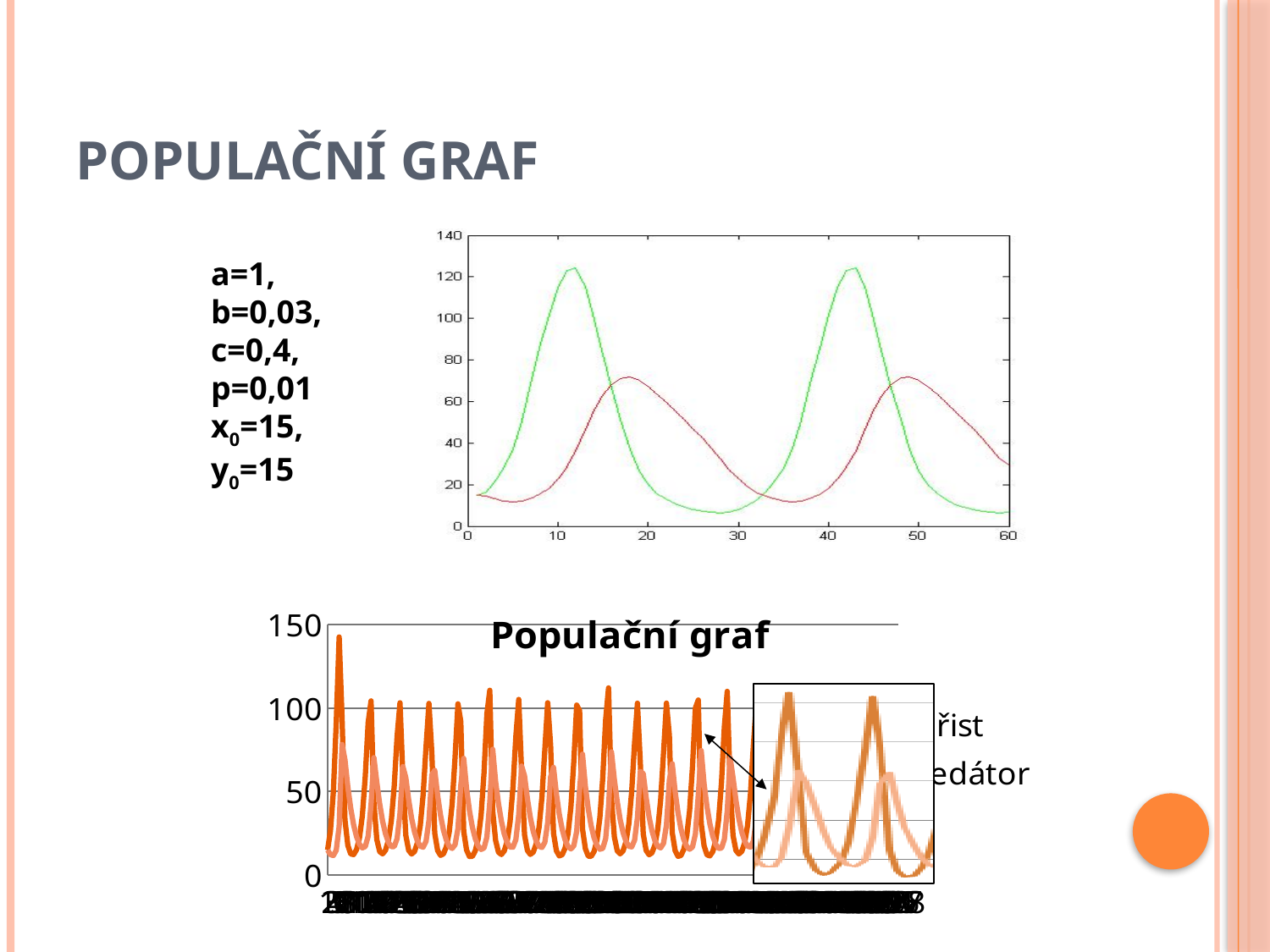
What is the title of the bottom chart? Populační graf In the bottom chart, is the first peak of the dark orange line greater or less than 100? greater In the top chart, is the lowest value of the green line greater or less than 20? less What kind of chart is the top chart on the slide? line chart In the top chart, is the peak value of the green line greater or less than 100? greater What is the highest value shown on the y axis of the top chart? 140 What kind of chart is the bottom chart on the slide? line chart In the top chart, does the green line rise or fall between x=15 and x=25? fall In the bottom chart, how many series are plotted? 2 In the top chart, which line reaches the higher peak, the green line or the red line? green line In the top chart, how many lines are plotted? 2